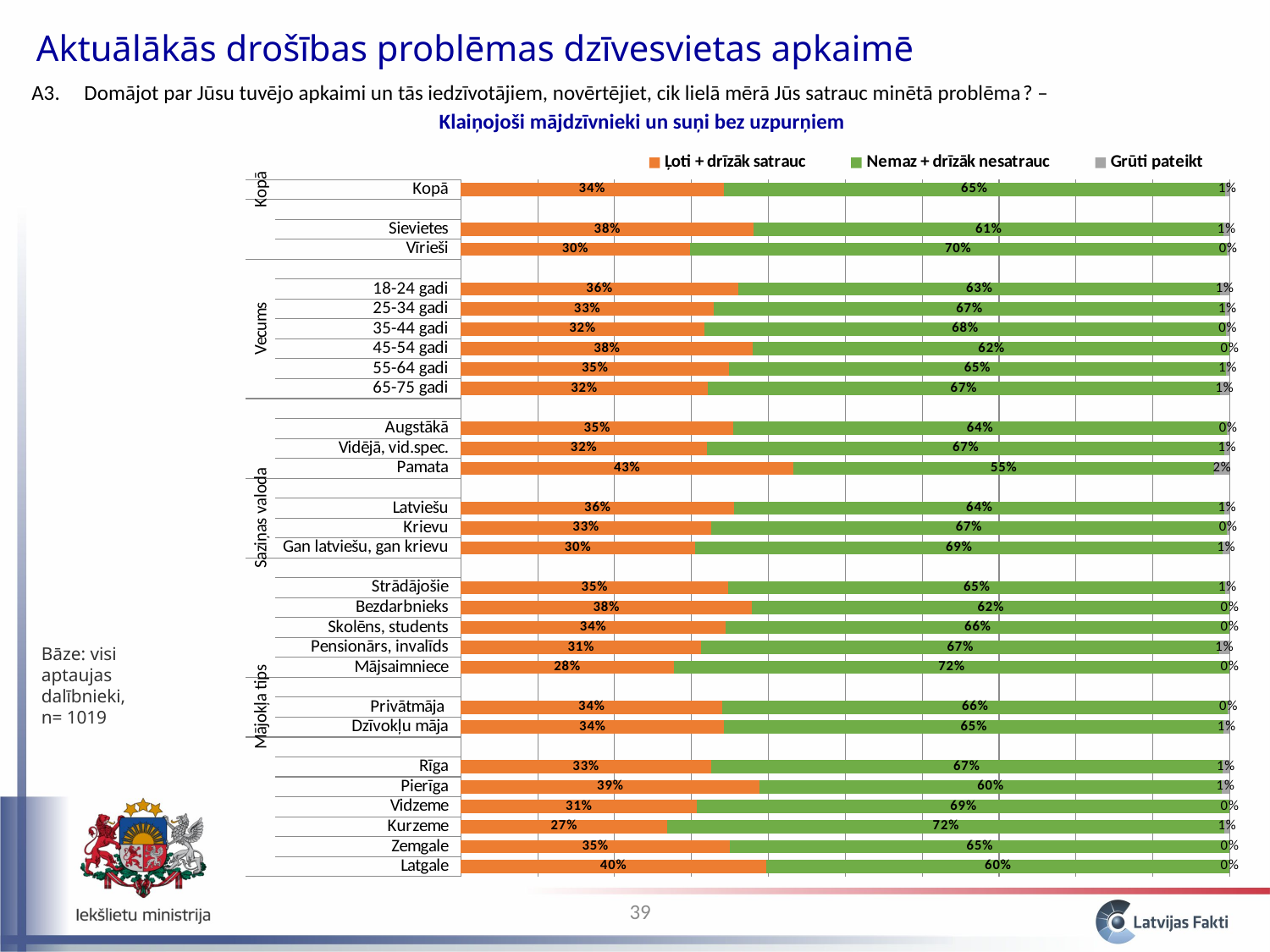
Which category has the highest value for "Ļoti + drīzāk satrauc"? Pamata Which category has the lowest value for "Nemaz + drīzāk nesatrauc"? Pamata What is the value of "Ļoti + drīzāk satrauc" for Kopā? 34% Which has a larger "Ļoti + drīzāk satrauc" value, Latgale or Rīga? Latgale How many categories are plotted in the chart? 28 Which category has the lowest value for "Ļoti + drīzāk satrauc"? Kurzeme What kind of chart is shown on the slide? Stacked bar chart What is the value of "Grūti pateikt" for Pamata? 2% How many series does the legend list? 3 What is the difference between the "Ļoti + drīzāk satrauc" values for Sievietes and Vīrieši? 8% What is the value of "Nemaz + drīzāk nesatrauc" for Vīrieši? 70% What is the title of the chart? Klaiņojoši mājdzīvnieki un suņi bez uzpurņiem